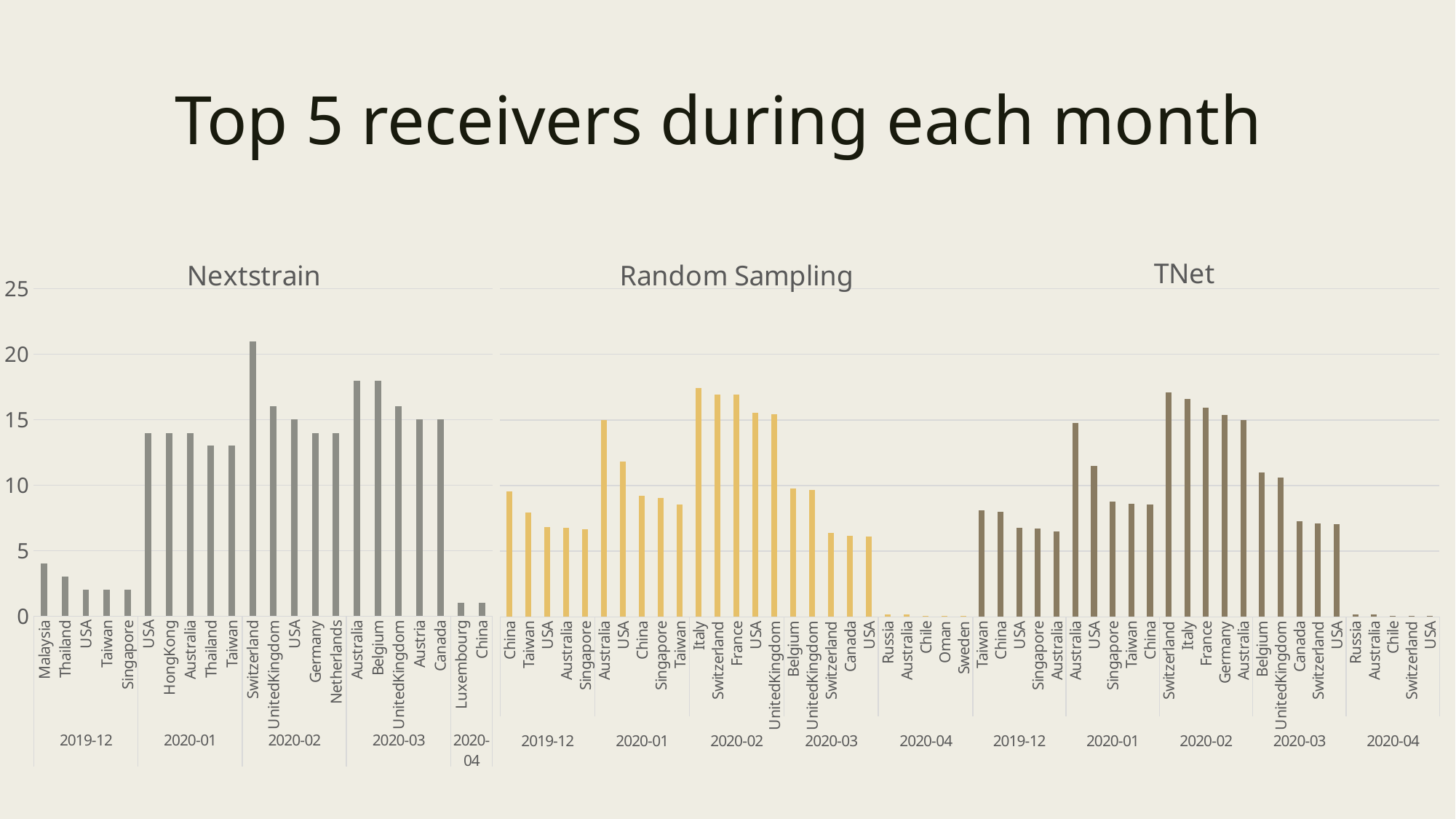
In the Random Sampling chart, is the value for Italy in 2020-02 greater or less than 15? greater In the Nextstrain chart, which is larger: Australia in 2020-03 or Thailand in 2019-12? Australia in 2020-03 In the TNet chart, which is larger: Switzerland in 2020-02 or Belgium in 2020-03? Switzerland in 2020-02 In the Random Sampling chart, is the value for Russia in 2020-04 greater or less than 5? less How many month groups are shown along the x axis of the TNet chart? 5 In the TNet chart, is the value for Taiwan in 2019-12 greater or less than 10? less What kind of chart is used for the Nextstrain panel? bar chart What are the titles of the three charts on the slide, from left to right? Nextstrain, Random Sampling, TNet In the Nextstrain chart, which country has the tallest bar? Switzerland